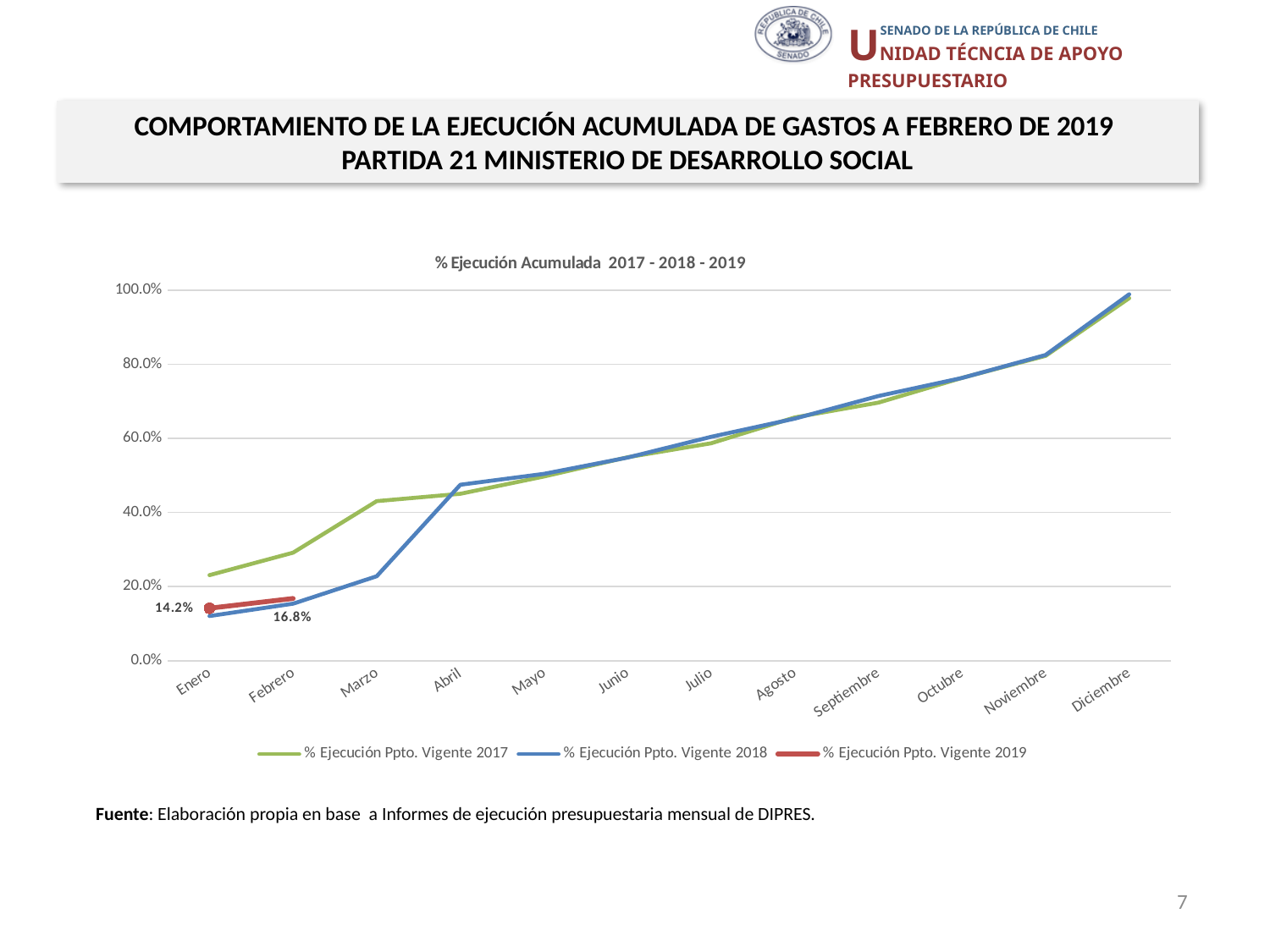
What is the value of % Ejecución Ppto. Vigente 2019 for Enero? 14.2% What kind of chart is shown on the slide? line chart What is the title of the chart? % Ejecución Acumulada 2017 - 2018 - 2019 What is the value of % Ejecución Ppto. Vigente 2019 for Febrero? 16.8% Is the value for % Ejecución Ppto. Vigente 2017 in Enero greater or less than 20%? greater How many months are shown on the x axis? 12 In Marzo, which series has the higher value: % Ejecución Ppto. Vigente 2017 or % Ejecución Ppto. Vigente 2018? % Ejecución Ppto. Vigente 2017 Is the value for % Ejecución Ppto. Vigente 2018 in Marzo greater or less than 40%? less How many series does the legend list? 3 Do the values of % Ejecución Ppto. Vigente 2017 rise or fall from Enero to Diciembre? rise Which month has the highest value for % Ejecución Ppto. Vigente 2018? Diciembre By how much did % Ejecución Ppto. Vigente 2019 increase from Enero to Febrero? 2.6%